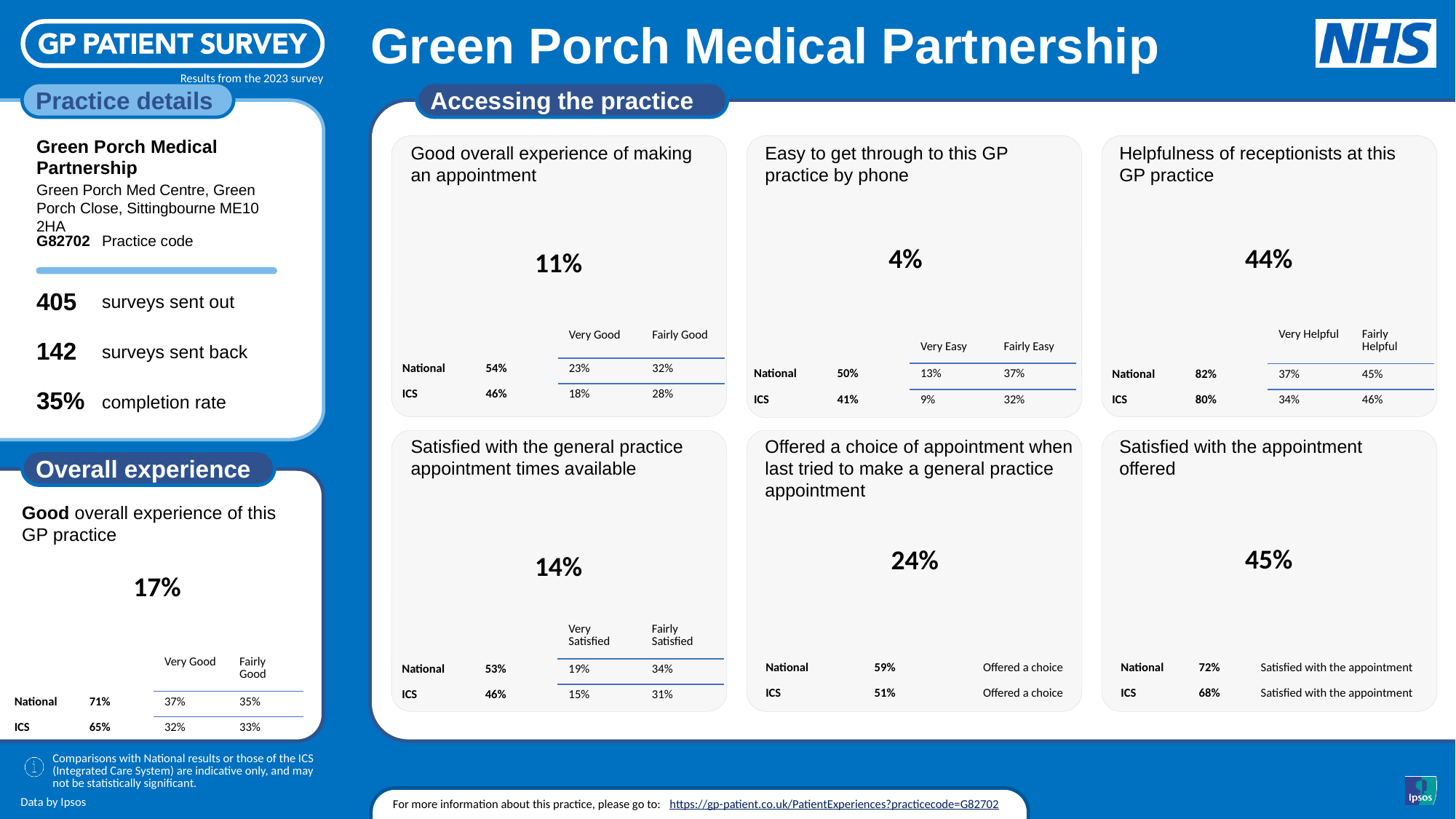
On the 'Easy to get through to this GP practice by phone' panel, what is the ICS 'Very Easy' value? 9% On the 'Helpfulness of receptionists at this GP practice' panel, what are the two response categories listed in the comparison table? Very Helpful, Fairly Helpful On the 'Offered a choice of appointment when last tried to make a general practice appointment' panel, what is the difference between the National value and the ICS value? 8% On the 'Easy to get through to this GP practice by phone' panel, what is the National value? 50% On the 'Satisfied with the general practice appointment times available' panel, what is the National 'Fairly Satisfied' value? 34% How many panels are shown under the 'Accessing the practice' heading? 6 On the 'Good overall experience of making an appointment' panel, what is the practice's headline value? 11% Among the six panels under 'Accessing the practice', which has the lowest practice headline value? Easy to get through to this GP practice by phone Among the six panels under 'Accessing the practice', which has the highest practice headline value? Satisfied with the appointment offered On the 'Satisfied with the appointment offered' panel, what is the practice's headline value? 45% On the 'Helpfulness of receptionists at this GP practice' panel, what is the ICS value? 80% On the 'Good overall experience of this GP practice' panel, which is larger, the National value or the ICS value? National